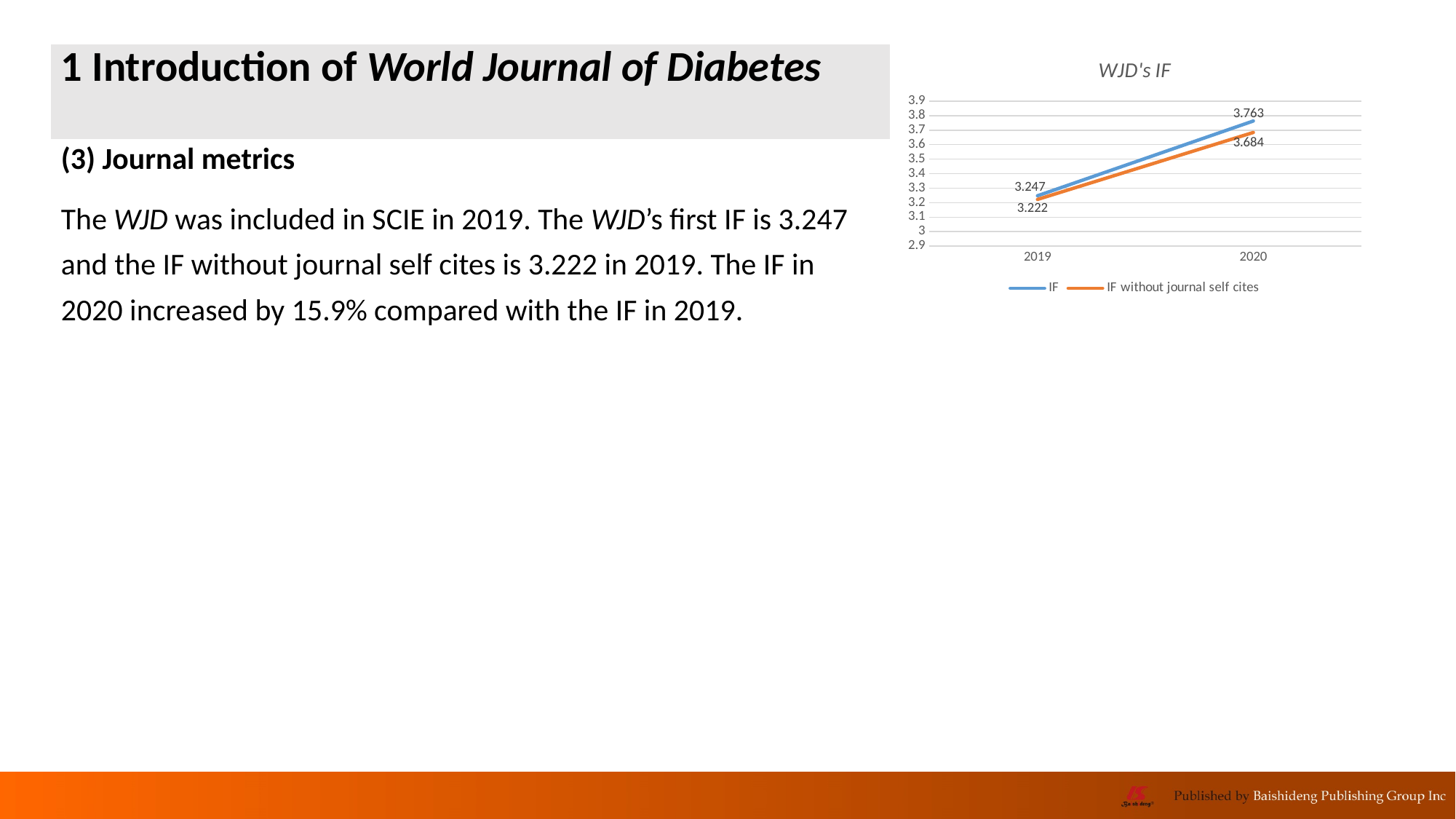
How many series does the legend list? 2 Does the IF rise or fall from 2019 to 2020? Rise What is the title of the chart? WJD's IF What is the difference between the IF in 2020 and the IF in 2019? 0.516 Which year has the lowest IF without journal self cites? 2019 What is the IF without journal self cites for 2020? 3.684 What is the IF value for 2020? 3.763 What is the IF without journal self cites for 2019? 3.222 In 2020, which is larger: the IF or the IF without journal self cites? IF What is the IF value for 2019? 3.247 What kind of chart is shown? Line chart Which year has the highest IF? 2020